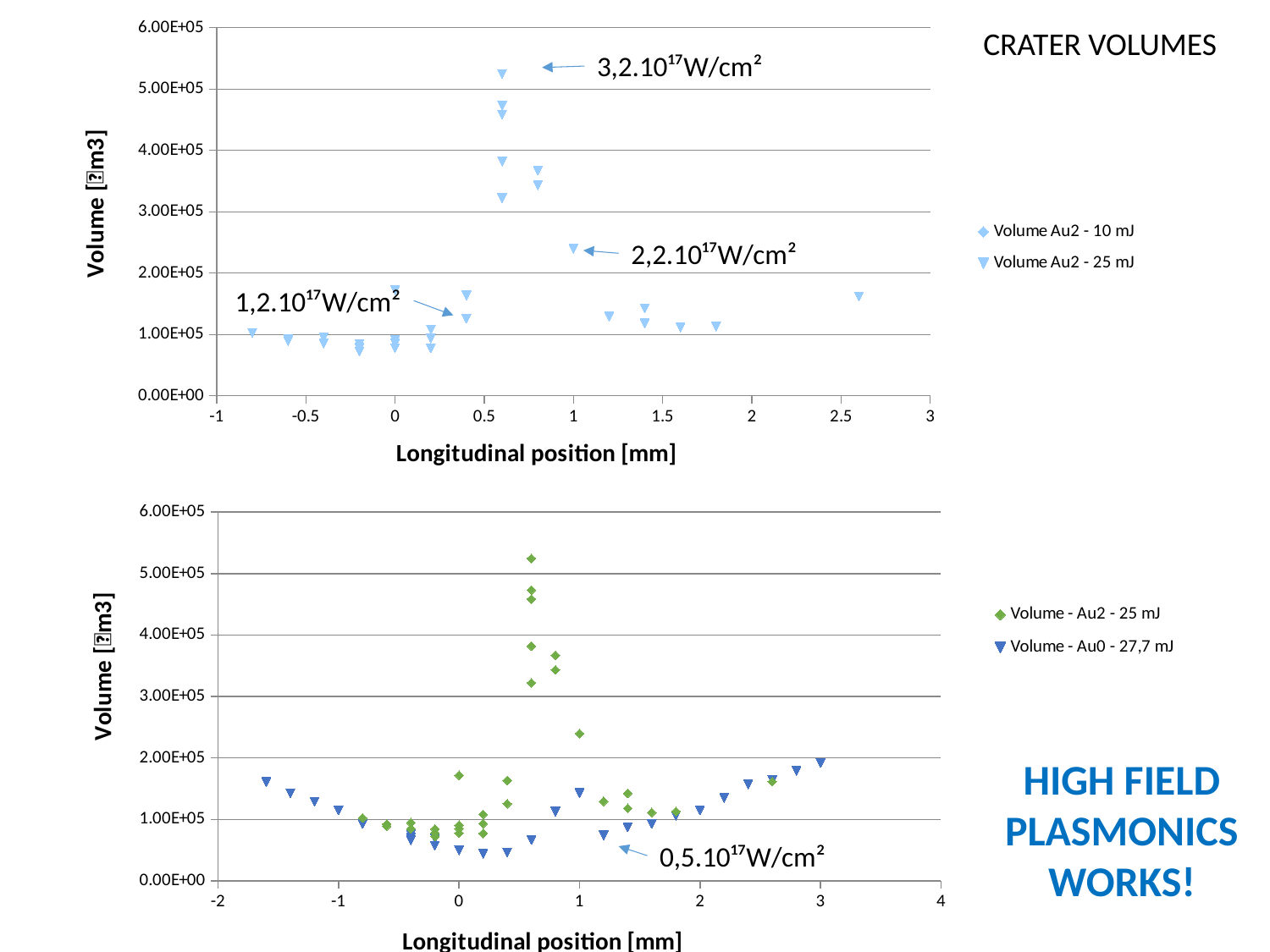
In the top chart, is the volume at longitudinal position 2.6 mm greater or less than 2.00E+05? less In the bottom chart, is the highest Volume - Au2 - 25 mJ point greater or less than 5.00E+05? greater In the top chart, is the volume at longitudinal position -0.8 mm greater or less than 2.00E+05? less What are the two legend entries of the bottom chart? Volume - Au2 - 25 mJ; Volume - Au0 - 27,7 mJ In the top chart, which intensity annotation points to the highest cluster of points? 3,2.10¹⁷W/cm² How many series does the legend of the top chart list? 2 In the bottom chart, at longitudinal position 0.6 mm, which series has the larger volume: Volume - Au2 - 25 mJ or Volume - Au0 - 27,7 mJ? Volume - Au2 - 25 mJ How many series does the legend of the bottom chart list? 2 What kind of chart is the top chart on the slide? scatter chart